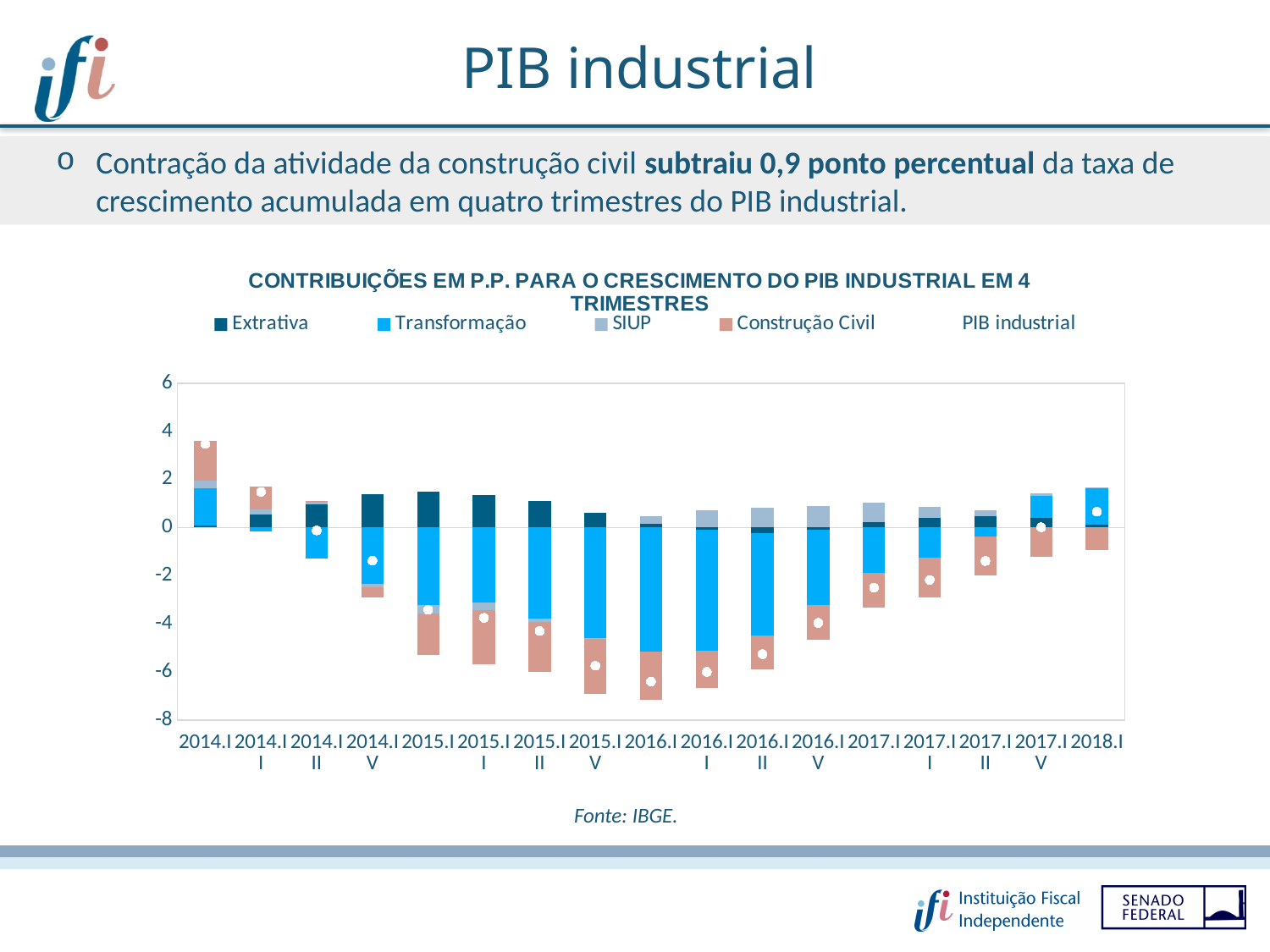
Is the PIB industrial value for 2018.I greater or less than 0? greater How many series does the legend list? 5 Which series is shown in the salmon/pink colour in the legend? Construção Civil Is the PIB industrial value for 2014.I greater or less than 2? greater What kind of chart is shown on the slide? Stacked bar chart with a line/marker series Does the PIB industrial series rise or fall from 2016.I to 2018.I? rise Is the PIB industrial value for 2016.I greater or less than -6? less In which quarter is the PIB industrial marker lowest? 2016.I In which quarter is the PIB industrial marker highest? 2014.I What is the title of the chart? CONTRIBUIÇÕES EM P.P. PARA O CRESCIMENTO DO PIB INDUSTRIAL EM 4 TRIMESTRES How many quarters (categories) are plotted along the x axis? 17